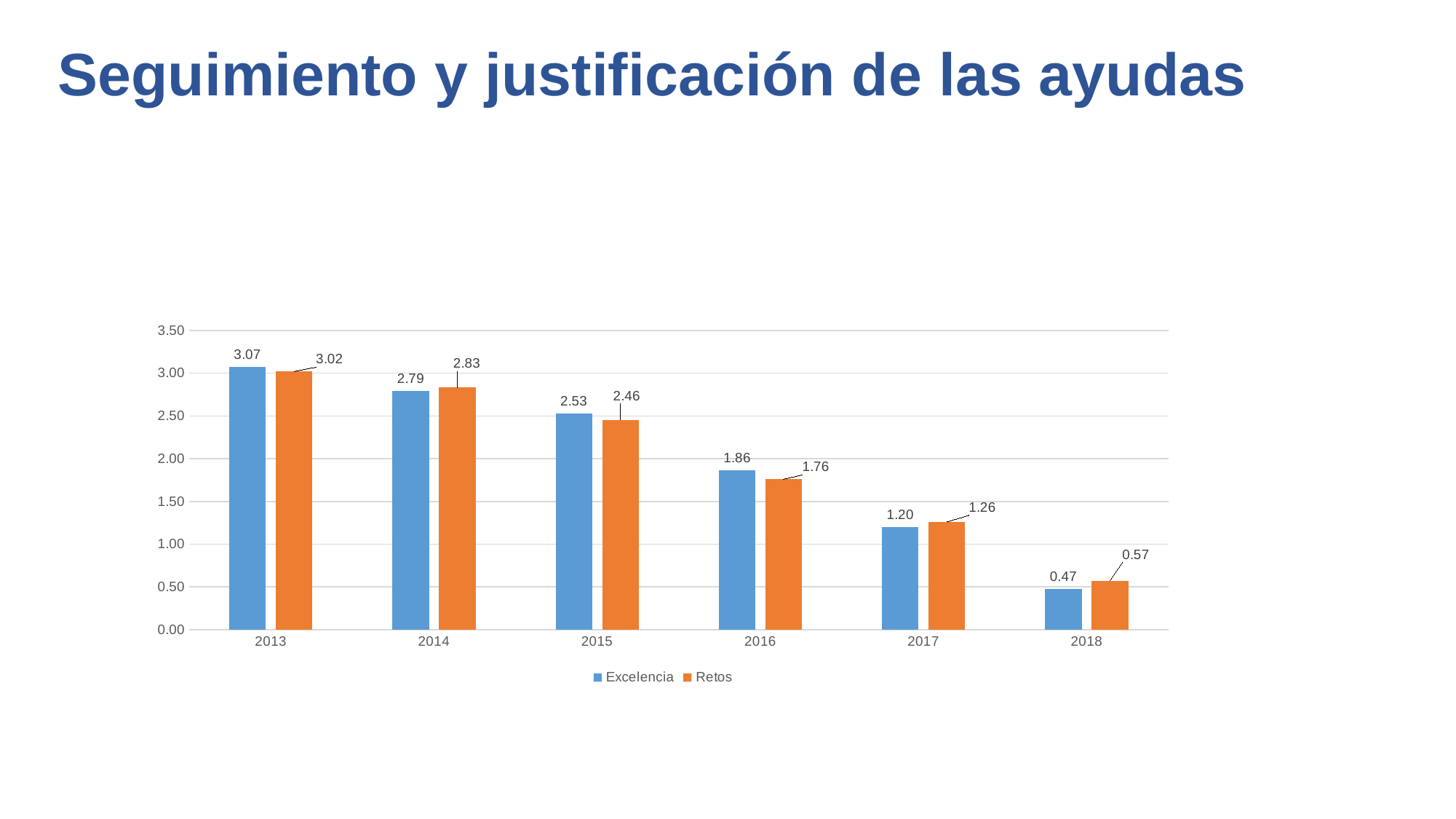
What kind of chart is shown on the slide? bar chart What is the value for Excelencia in 2013? 3.07 How many series does the legend list? 2 What is the difference between Excelencia and Retos in 2015? 0.07 Do the Excelencia values rise or fall from 2013 to 2018? fall Which is larger in 2017, Excelencia or Retos? Retos How many years are shown on the x axis? 6 What is the value for Retos in 2018? 0.57 Which year has the lowest value for Retos? 2018 Which year has the highest value for Excelencia? 2013 Is the value for Excelencia in 2016 greater or less than 2.00? less What is the value for Retos in 2016? 1.76